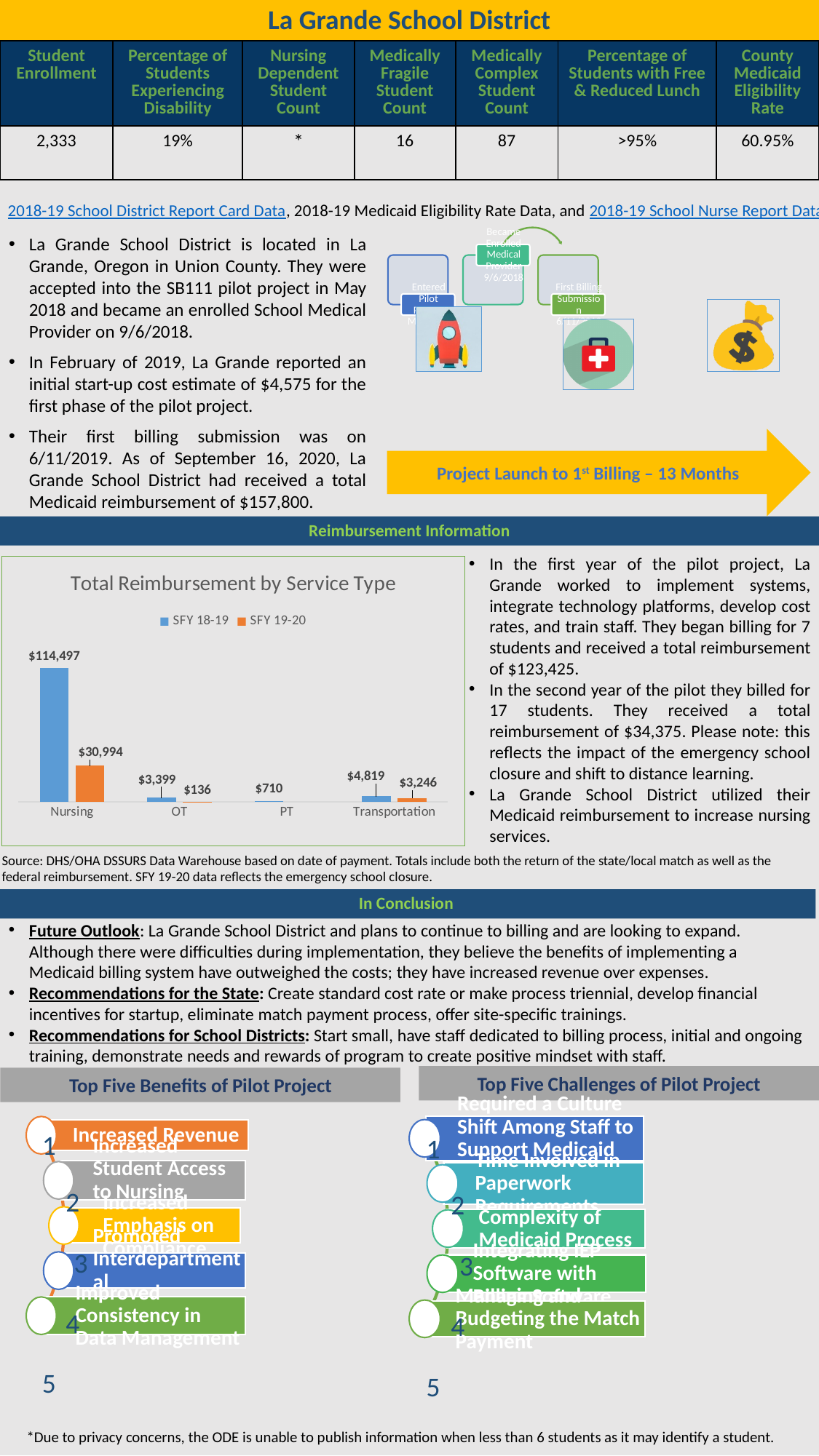
In the Total Reimbursement by Service Type chart, which service type has the highest SFY 18-19 reimbursement? Nursing How many service type categories are shown on the x axis of the Total Reimbursement by Service Type chart? 4 What kind of chart is the Total Reimbursement by Service Type chart? Bar chart In the Total Reimbursement by Service Type chart, what is the SFY 18-19 value for Transportation? $4,819 In the Total Reimbursement by Service Type chart, which is larger for SFY 18-19: OT or Transportation? Transportation In the Total Reimbursement by Service Type chart, what is the SFY 18-19 value for Nursing? $114,497 In the Total Reimbursement by Service Type chart, what is the difference between the SFY 18-19 and SFY 19-20 values for Transportation? $1,573 How many series does the legend of the Total Reimbursement by Service Type chart list? 2 In the Total Reimbursement by Service Type chart, which service type has the smallest reimbursement overall? PT In the Total Reimbursement by Service Type chart, what is the SFY 19-20 value for Nursing? $30,994 In the Total Reimbursement by Service Type chart, what is the SFY 19-20 value for OT? $136 In the Total Reimbursement by Service Type chart, what is the difference between the SFY 18-19 and SFY 19-20 values for Nursing? $83,503